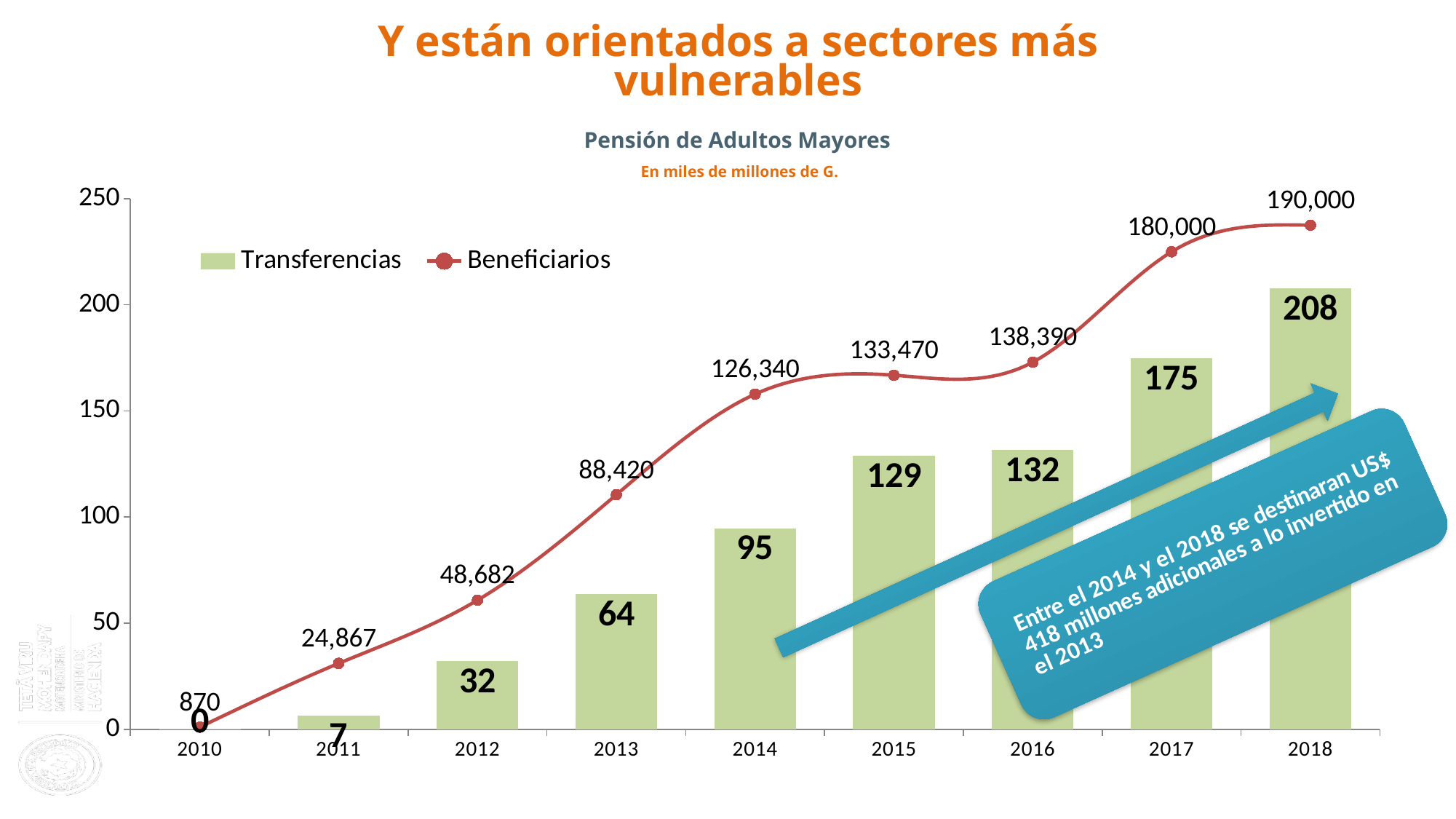
What is the Transferencias value for 2018? 208 Do the Beneficiarios values rise or fall from 2010 to 2018? rise Which is larger, the Transferencias value for 2015 or for 2016? 2016 Which year has the highest Transferencias value? 2018 Which year has the lowest Beneficiarios value? 2010 How many series does the legend list? 2 What is the Beneficiarios value for 2011? 24,867 What is the Transferencias value for 2013? 64 What is the Beneficiarios value for 2014? 126,340 How many years are shown on the x axis? 9 What is the difference between the Transferencias values for 2018 and 2017? 33 What is the title of the chart? Pensión de Adultos Mayores